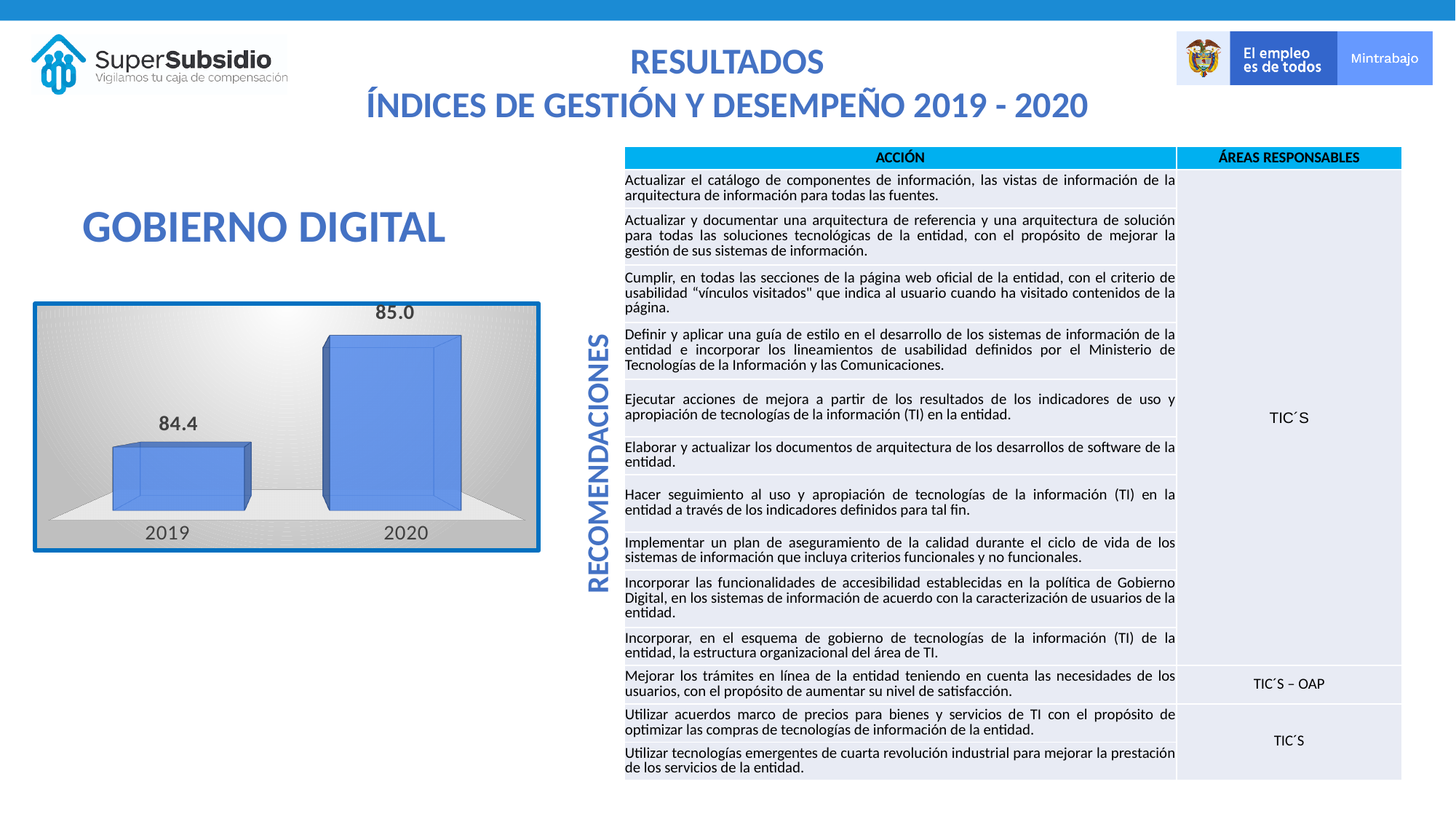
How many years are shown in the Gobierno Digital chart? 2 Does the value rise or fall from 2019 to 2020 in the Gobierno Digital chart? rise What is the value for 2019 in the Gobierno Digital chart? 84.4 What kind of chart is used to show the Gobierno Digital results? bar chart Which year has the lower value in the Gobierno Digital chart? 2019 Is the value for 2020 larger or smaller than the value for 2019 in the Gobierno Digital chart? larger What is the value for 2020 in the Gobierno Digital chart? 85.0 What colour are the bars in the Gobierno Digital chart? blue Which year has the higher value in the Gobierno Digital chart? 2020 What is the difference between the 2020 and 2019 values in the Gobierno Digital chart? 0.6 What is the heading shown above the chart on the left of the slide? GOBIERNO DIGITAL